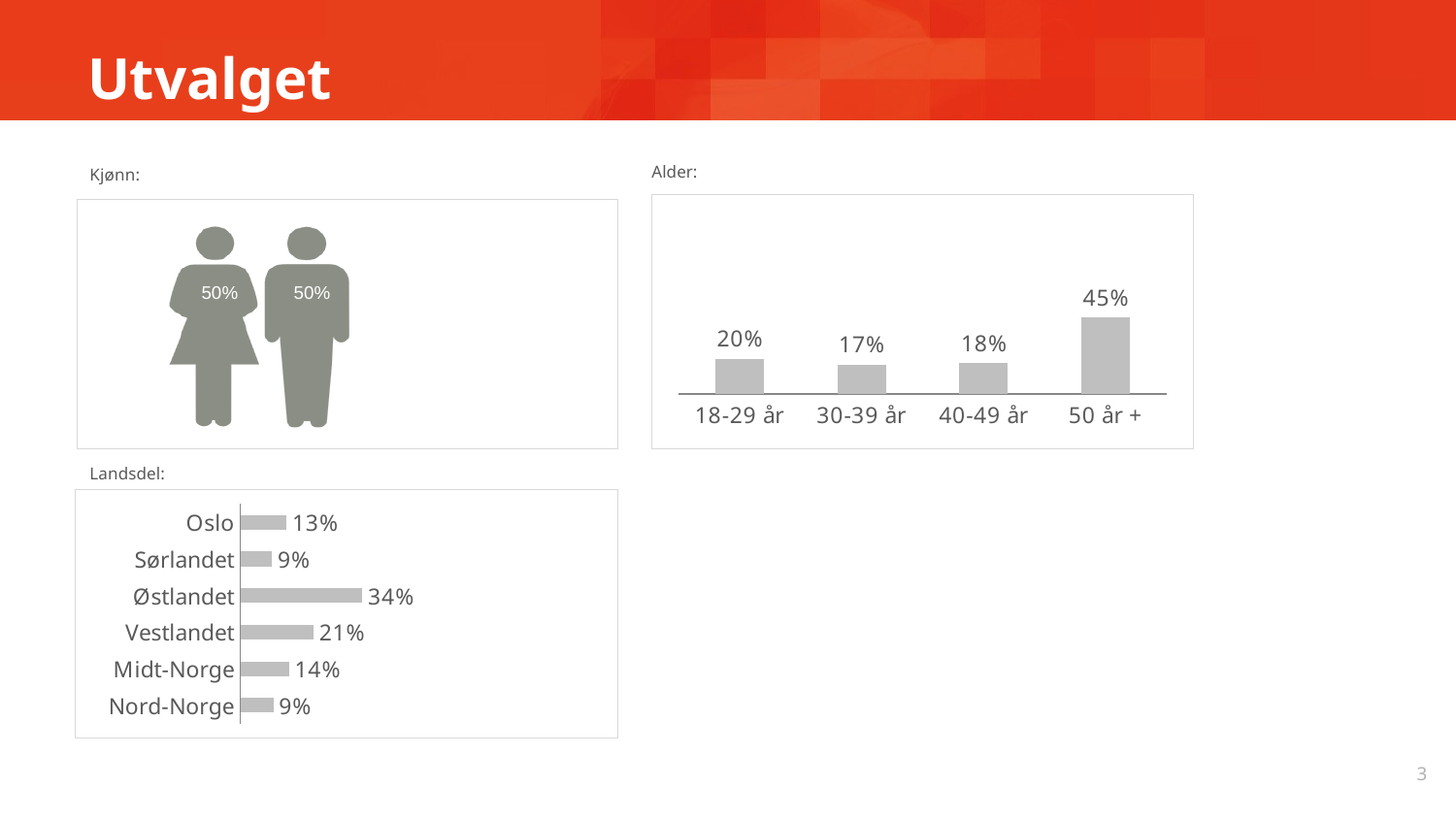
In the Landsdel chart, which is larger, the value for Oslo or the value for Midt-Norge? Midt-Norge In the Landsdel chart, how many regions are listed? 6 In the Alder chart, what is the difference between the values for 50 år + and 18-29 år? 25 percentage points In the Alder chart, which age group has the highest value? 50 år + In the Alder chart, which age group has the lowest value? 30-39 år In the Landsdel chart, what is the difference between the values for Østlandet and Sørlandet? 25 percentage points What kind of chart is the Landsdel chart? Bar chart In the Alder chart, how many age groups are shown? 4 In the Landsdel chart, which region has the highest value? Østlandet In the Landsdel chart, what is the value for Østlandet? 34% In the Landsdel chart, what is the value for Vestlandet? 21% In the Alder chart, what is the value for 50 år +? 45%